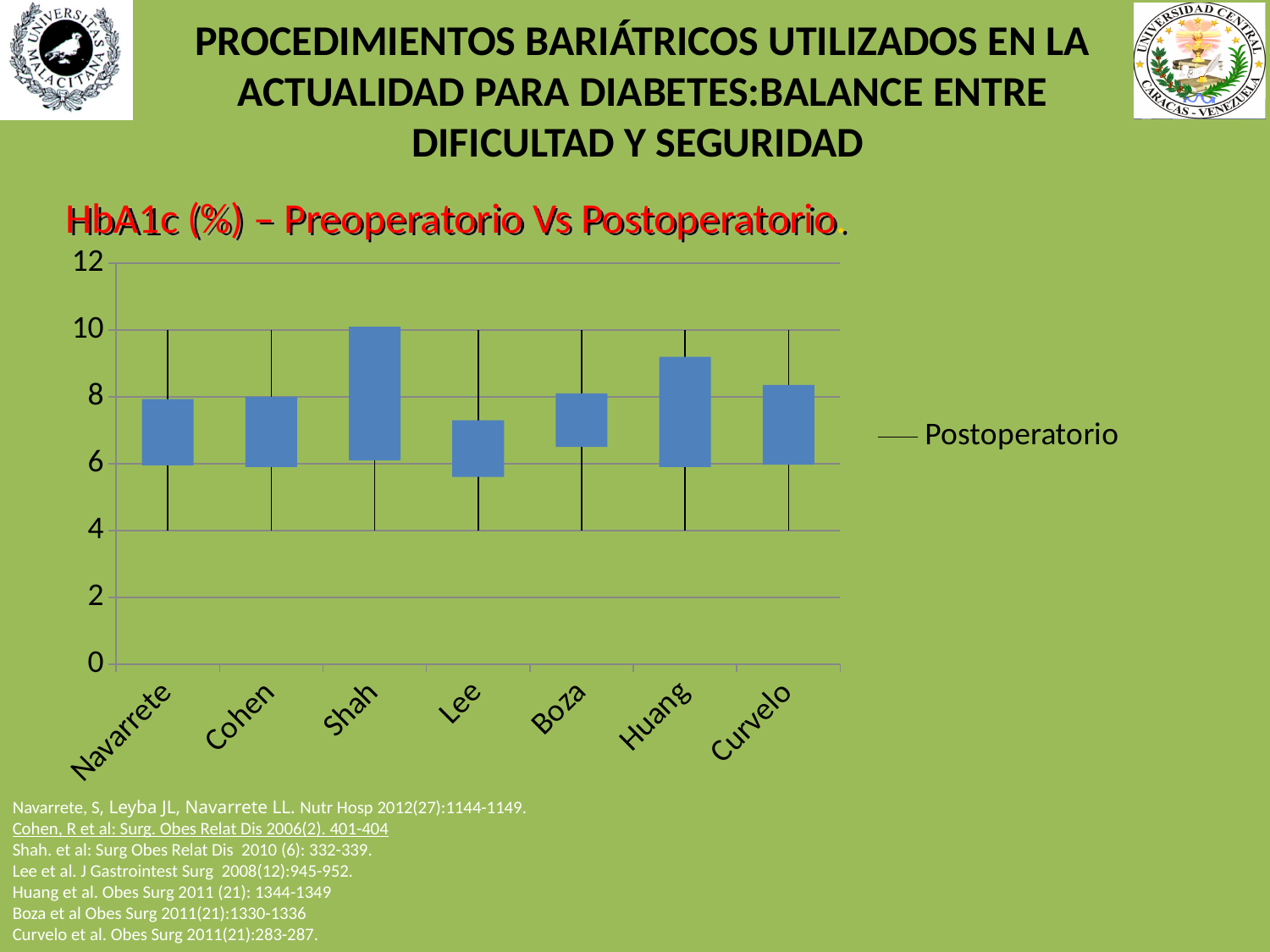
Which bar reaches a higher value, Shah or Lee? Shah Is the top of the bar for Shah greater or less than 8? greater What is the maximum value shown on the vertical axis of the chart? 12 Which study has the bar that reaches the highest value on the chart? Shah What is the name of the series listed in the chart legend? Postoperatorio Is the top of the bar for Huang greater or less than 8? greater Which study has the bar that extends to the lowest value on the chart? Lee How many studies (categories) are shown on the x axis of the chart? 7 Is the top of the bar for Lee greater or less than 8? less What is the title of the chart? HbA1c (%) – Preoperatorio Vs Postoperatorio How many series does the chart legend list? 1